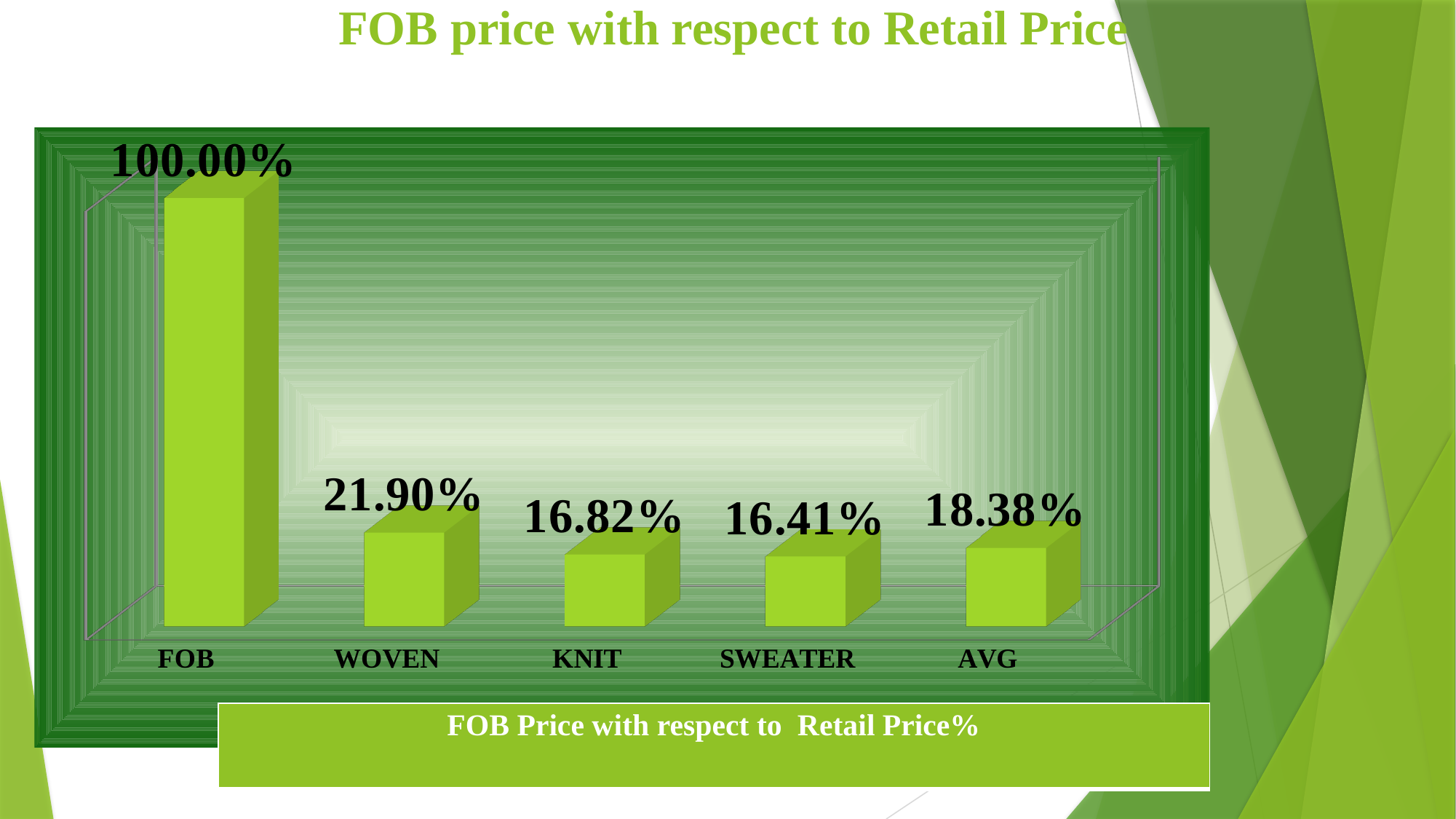
What is the difference between the values for WOVEN and KNIT? 5.08% Which category has the lowest value? SWEATER What is the value for WOVEN? 21.90% What is the value for KNIT? 16.82% What is the value for AVG? 18.38% Which category has the highest value? FOB What kind of chart is shown on the slide? bar chart What is the difference between the values for FOB and AVG? 81.62% Which is larger, the value for WOVEN or the value for AVG? WOVEN What is the legend entry shown below the chart? FOB Price with respect to Retail Price% What is the value for SWEATER? 16.41% How many categories are shown on the x axis? 5